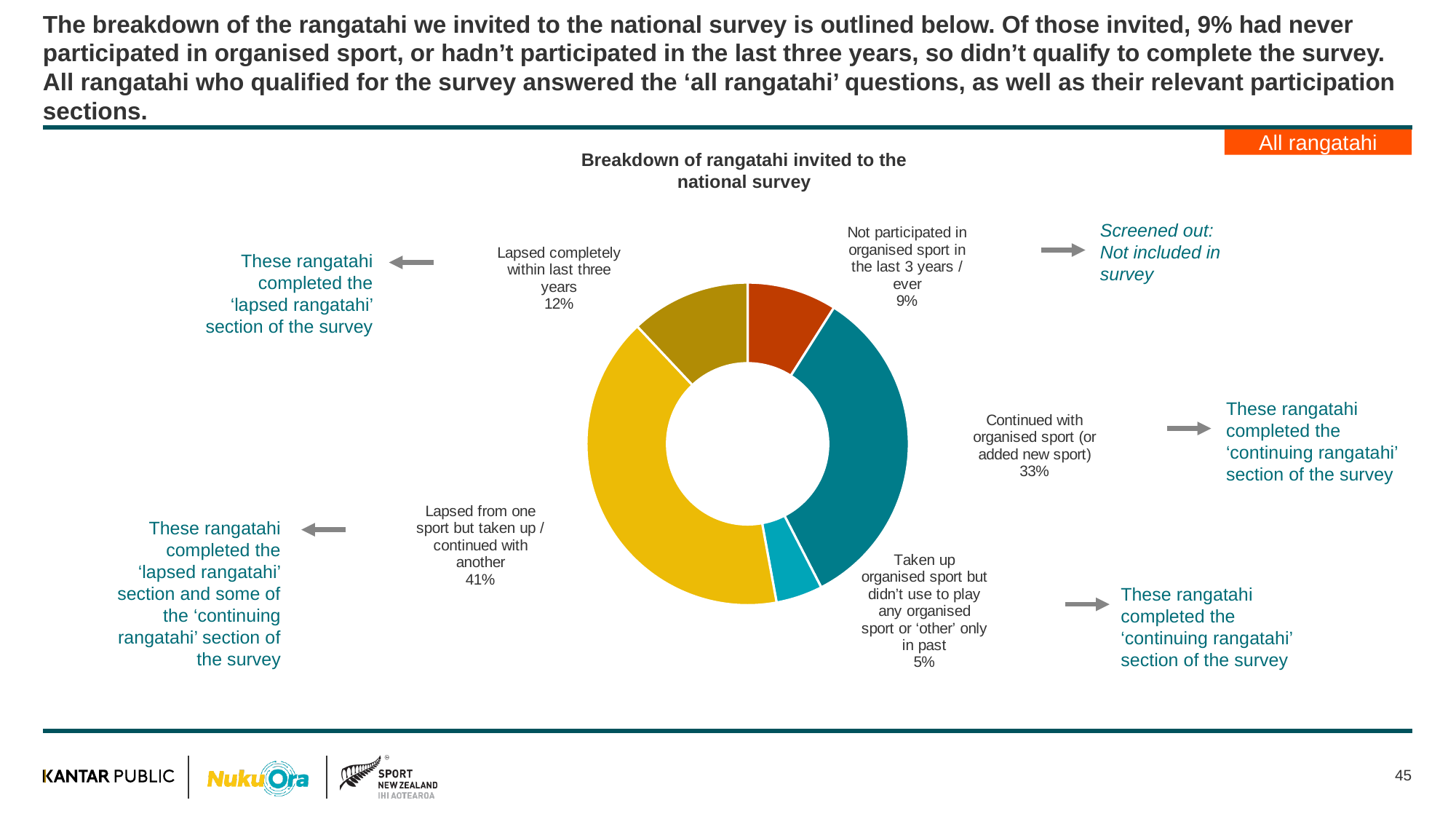
Which category makes up the largest share of rangatahi invited to the national survey? Lapsed from one sport but taken up / continued with another Which category makes up the smallest share of rangatahi invited to the national survey? Taken up organised sport but didn't use to play any organised sport or 'other' only in past What percentage of invited rangatahi had taken up organised sport but didn't use to play any organised sport or 'other' only in past? 5% What percentage of rangatahi invited to the national survey had lapsed from one sport but taken up / continued with another? 41% What percentage of invited rangatahi had not participated in organised sport in the last 3 years / ever? 9% What is the difference in percentage points between the 'Lapsed from one sport but taken up / continued with another' and 'Continued with organised sport (or added new sport)' segments? 8 percentage points What is the title of the chart on the slide? Breakdown of rangatahi invited to the national survey Which is larger: the share who lapsed completely within the last three years or the share who had not participated in organised sport in the last 3 years / ever? Lapsed completely within last three years What type of chart is used to show the breakdown of rangatahi invited to the national survey? Doughnut (pie) chart What share of invited rangatahi continued with organised sport (or added new sport)? 33% What percentage of invited rangatahi had lapsed completely within the last three years? 12% How many categories are shown in the chart of rangatahi invited to the national survey? 5